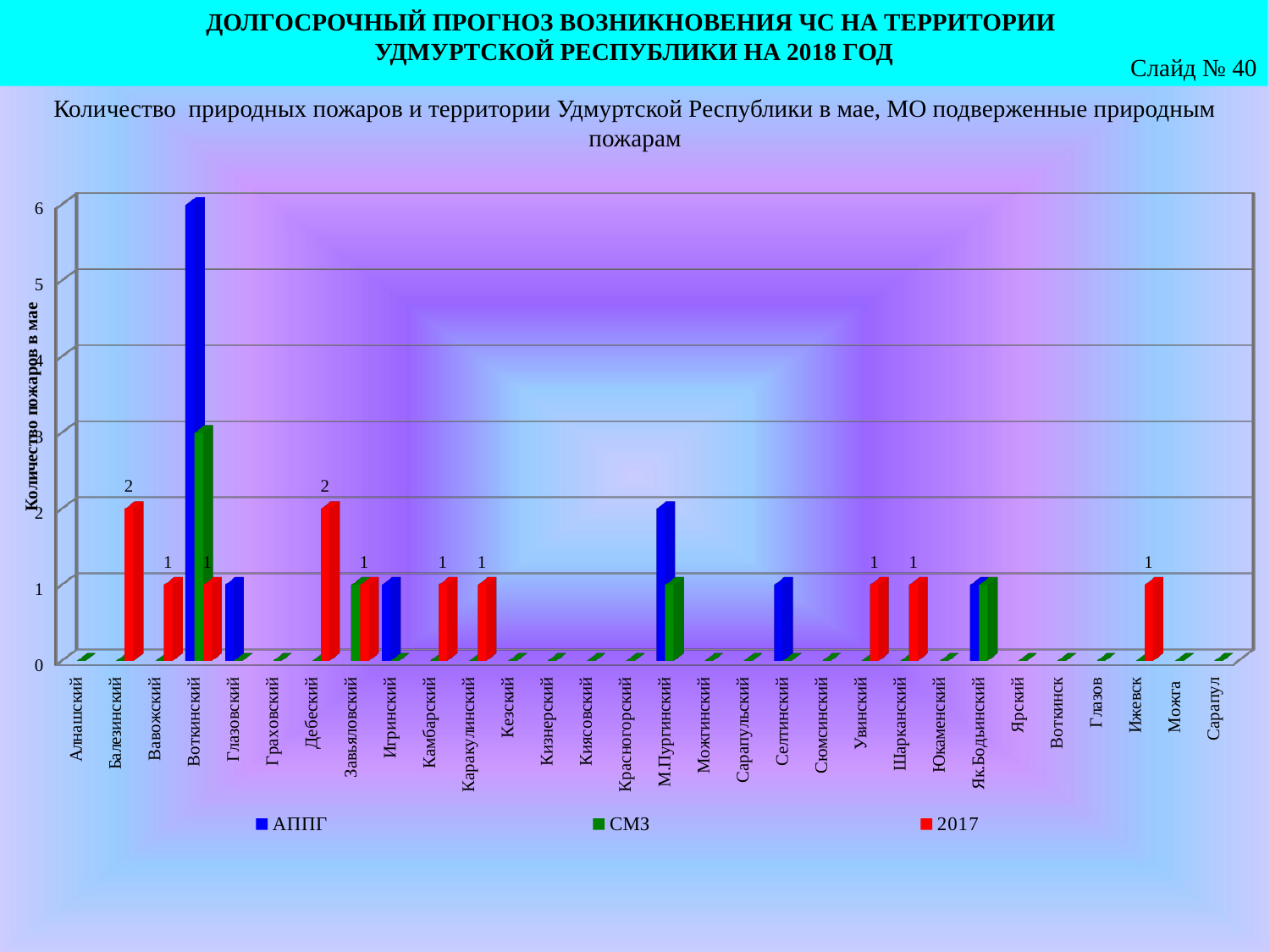
What kind of chart is shown on the slide? bar chart Which category has the highest АППГ value? Воткинский Is the АППГ value for Воткинский greater or less than 5? greater Which has the larger 2017 value, Балезинский or Камбарский? Балезинский What is the АППГ value for Воткинский? 6 What is the 2017 value for Дебесский? 2 What is the 2017 value for Ижевск? 1 For Воткинский, which series has the larger value, АППГ or СМЗ? АППГ What is the 2017 value for Балезинский? 2 How many categories are shown on the x axis? 30 What is the difference between the 2017 values for Балезинский and Вавожский? 1 How many series does the legend list? 3